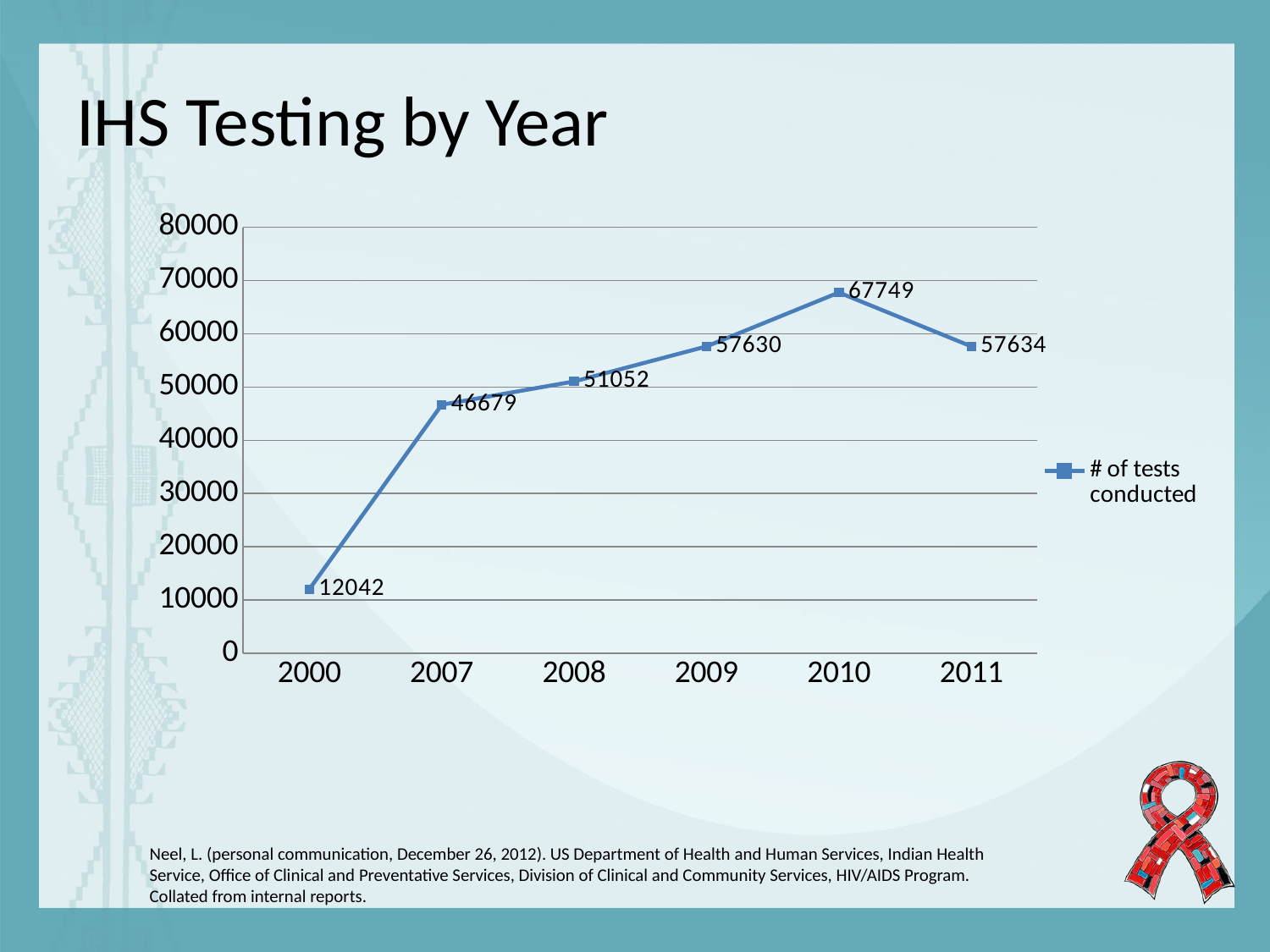
How many tests were conducted in 2000? 12042 What kind of chart is shown on the slide? line chart How many years are plotted on the x axis? 6 What is the difference in the number of tests conducted between 2007 and 2000? 34637 Which year had more tests conducted, 2007 or 2009? 2009 Is the number of tests conducted in 2010 greater or less than 60000? greater What is the difference in the number of tests conducted between 2010 and 2011? 10115 How many tests were conducted in 2008? 51052 What is the name of the series shown in the legend? # of tests conducted Which year had the lowest number of tests conducted? 2000 Which year had the highest number of tests conducted? 2010 How many tests were conducted in 2010? 67749